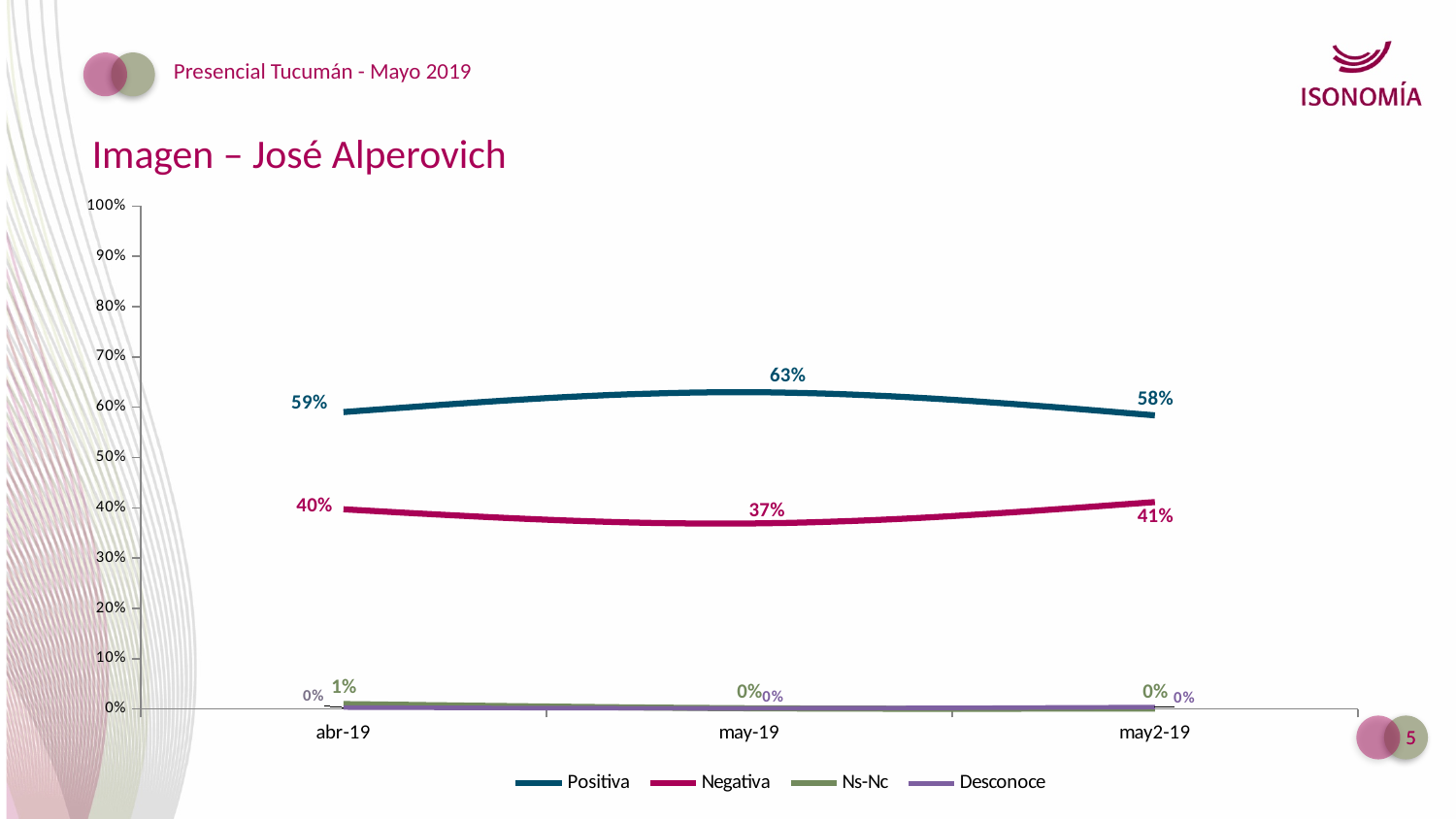
How many points are on the x axis? 3 At which x-axis point is the Positiva series highest? may-19 What kind of chart is shown on the slide? line chart What is the difference between the Positiva and Negativa values at may2-19? 17% Which is larger at abr-19, Positiva or Negativa? Positiva How many series does the legend list? 4 What is the Negativa value for abr-19? 40% What is the Positiva value for may-19? 63% Is the Positiva value for may-19 greater or less than 60%? greater What is the Positiva value for may2-19? 58% At which x-axis point is the Negativa series lowest? may-19 What is the Ns-Nc value for abr-19? 1%